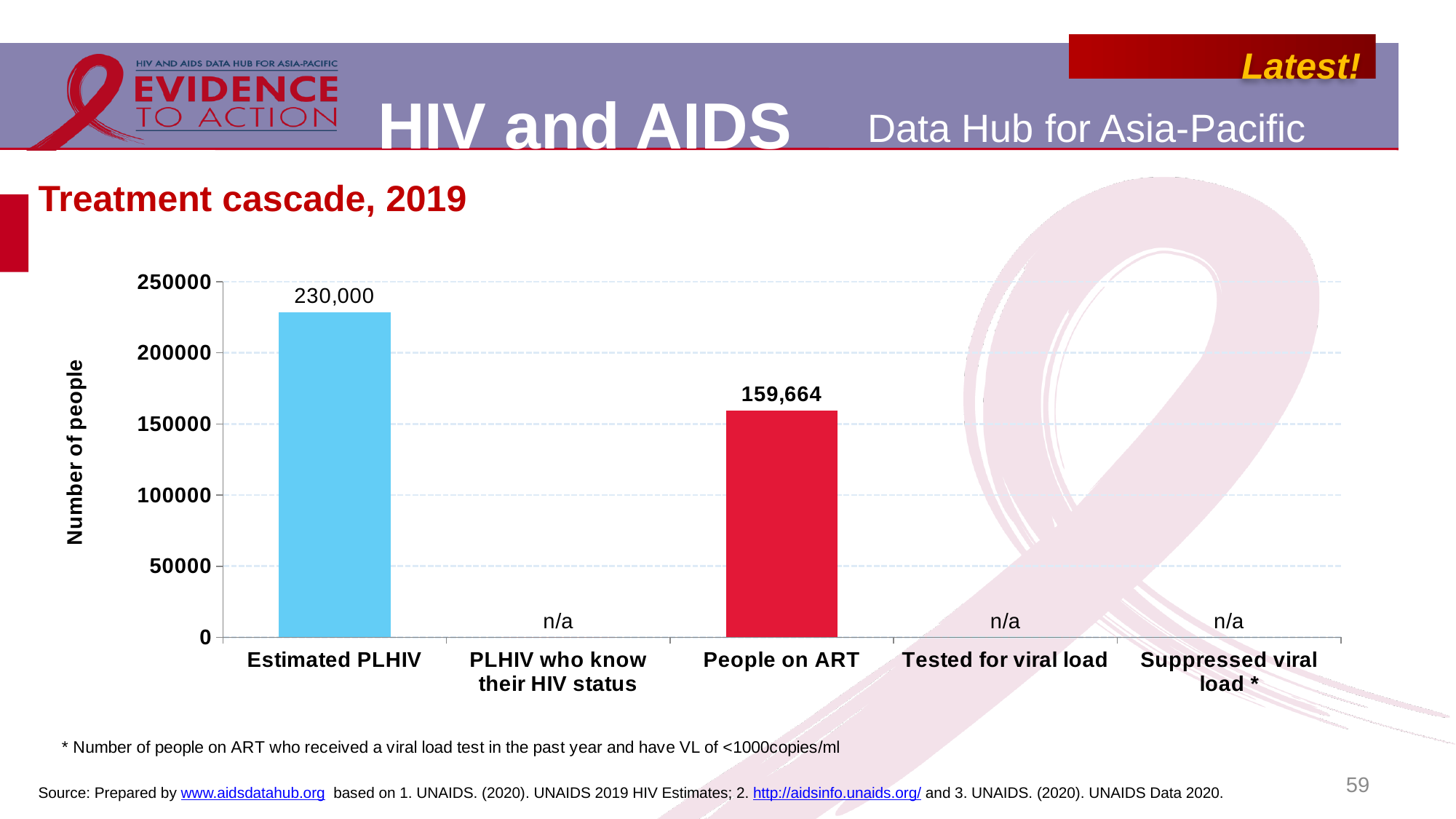
Is the value for People on ART greater or less than 150000? greater Which category has the highest value? Estimated PLHIV How many categories are shown on the x axis? 5 What is shown for PLHIV who know their HIV status? n/a Which is larger, Estimated PLHIV or People on ART? Estimated PLHIV What is the difference between Estimated PLHIV and People on ART? 70,336 What is the label of the y axis? Number of people What is shown for Tested for viral load? n/a What is the title of the chart? Treatment cascade, 2019 What kind of chart is this? bar chart What is the value for Estimated PLHIV? 230,000 What is the value for People on ART? 159,664